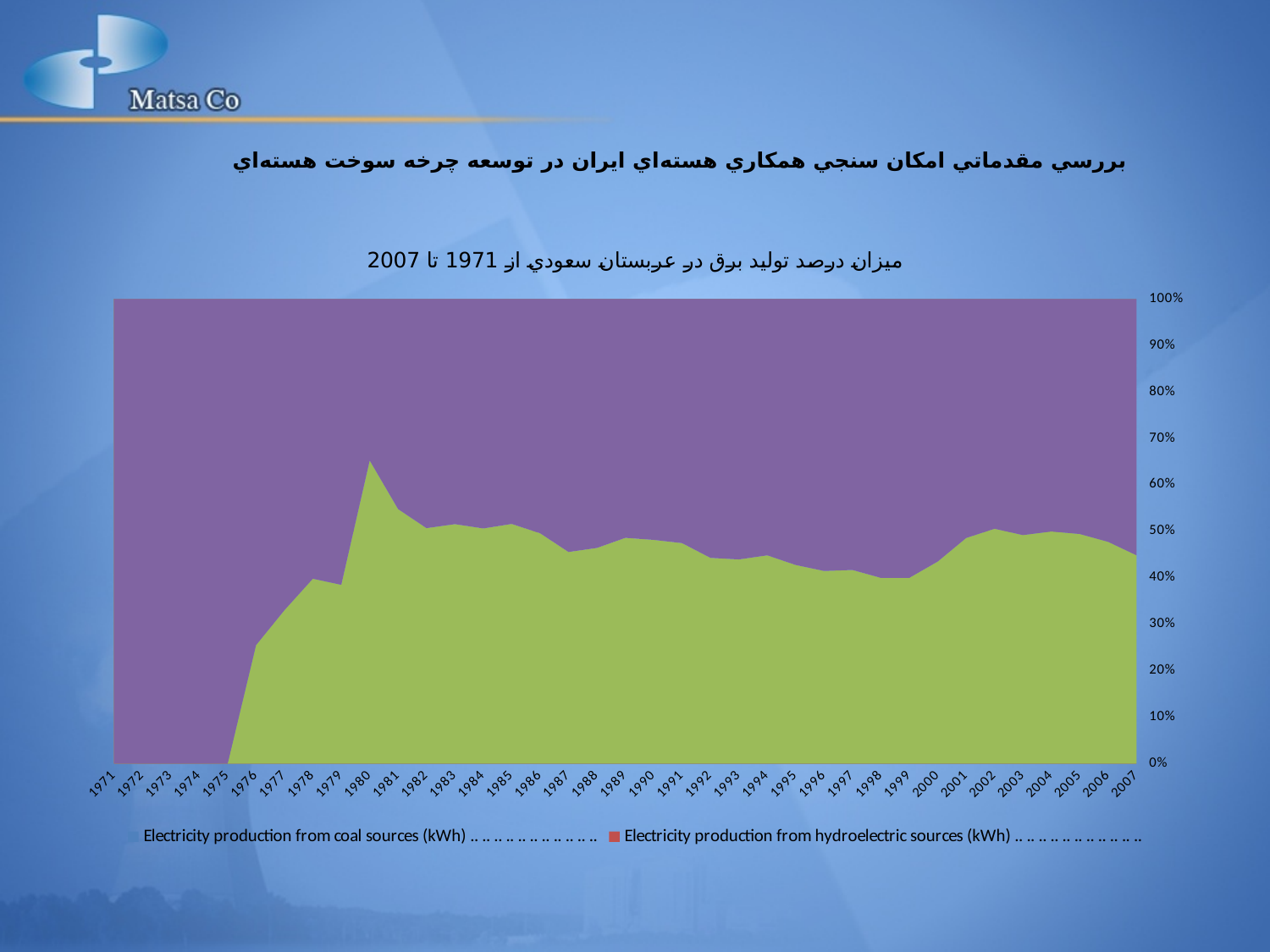
What is the first year shown on the x axis? 1971 What is the value for Electricity production from coal sources in 1973? 0% Is the value for Electricity production from coal sources in 1990 greater or less than 60%? less Is the value for Electricity production from coal sources in 1976 greater or less than 30%? less What is the last year shown on the x axis? 2007 How many years are shown along the x axis? 37 Is the value for Electricity production from coal sources in 1980 greater or less than 60%? less What kind of chart is shown on the slide? area chart How many series does the legend list? 2 What is the value for Electricity production from hydroelectric sources in 1972? 0%